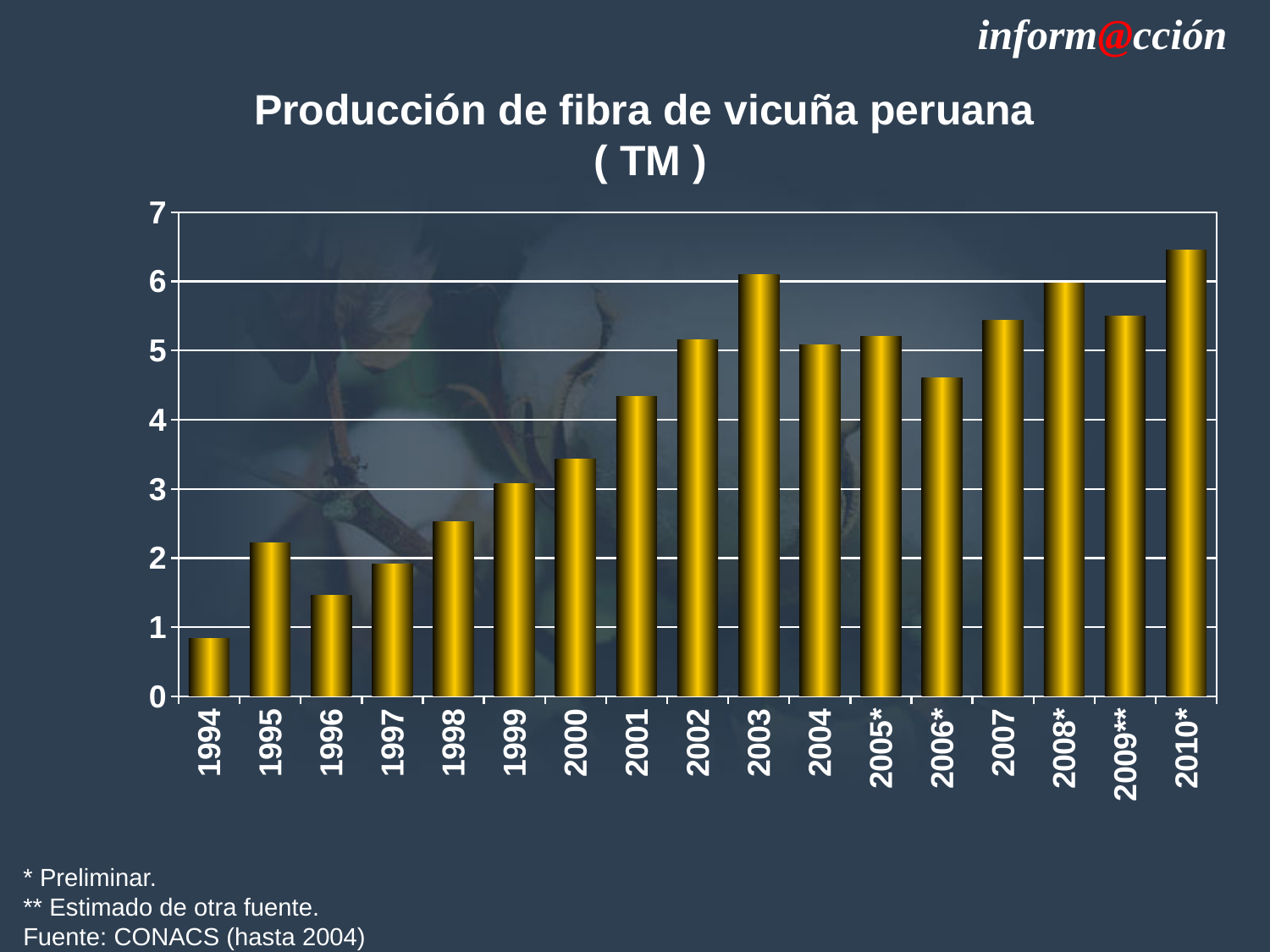
How many years are shown on the x axis? 17 Which is larger, the value for 2003 or the value for 2004? 2003 Is the value for 1994 greater or less than 1? less Which year has the highest vicuña fibre production? 2010* Is the value for 2006* greater or less than 5? less Which is larger, the value for 1995 or the value for 1996? 1995 Is the value for 1996 greater or less than 2? less What kind of chart is shown on the slide? bar chart Overall, do the values rise or fall from 1994 to 2010*? rise Which year has the lowest vicuña fibre production? 1994 What unit is given in the chart title? TM